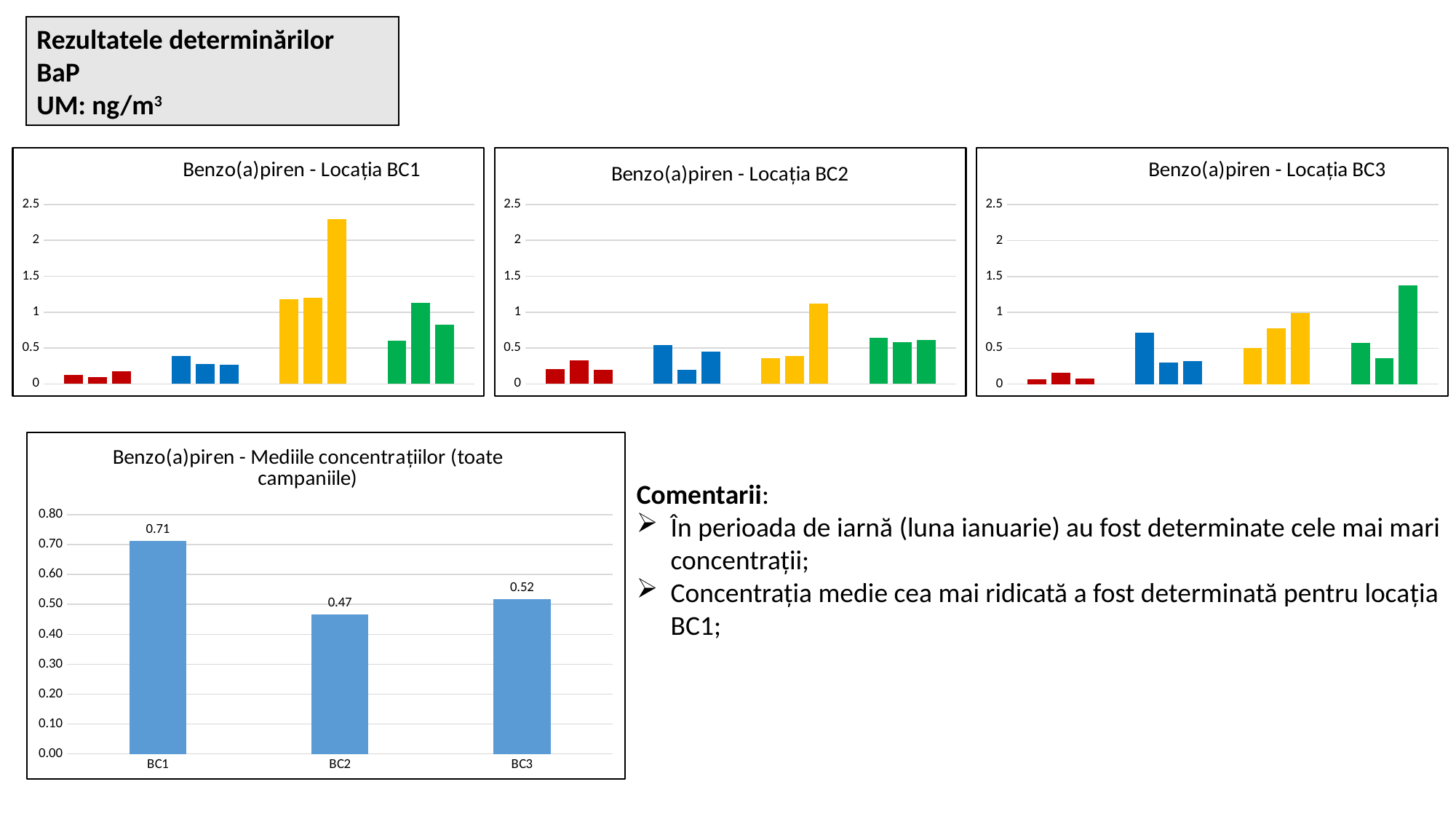
What kind of chart is 'Benzo(a)piren - Mediile concentrațiilor (toate campaniile)'? bar chart In the chart 'Benzo(a)piren - Locația BC2', is the tallest bar greater or less than 1.5? less In the chart 'Benzo(a)piren - Locația BC1', is the tallest bar greater or less than 2? greater In the chart 'Benzo(a)piren - Mediile concentrațiilor (toate campaniile)', which is larger, the value for BC3 or the value for BC2? BC3 In the chart 'Benzo(a)piren - Mediile concentrațiilor (toate campaniile)', what is the value for BC2? 0.47 In the chart 'Benzo(a)piren - Mediile concentrațiilor (toate campaniile)', which location has the highest value? BC1 In the chart 'Benzo(a)piren - Mediile concentrațiilor (toate campaniile)', what is the difference between the values for BC1 and BC2? 0.24 How many bars are plotted in the chart 'Benzo(a)piren - Locația BC3'? 12 In the chart 'Benzo(a)piren - Mediile concentrațiilor (toate campaniile)', what is the value for BC3? 0.52 In the chart 'Benzo(a)piren - Mediile concentrațiilor (toate campaniile)', which location has the lowest value? BC2 In the chart 'Benzo(a)piren - Mediile concentrațiilor (toate campaniile)', what is the value for BC1? 0.71 How many categories are shown in the chart 'Benzo(a)piren - Mediile concentrațiilor (toate campaniile)'? 3